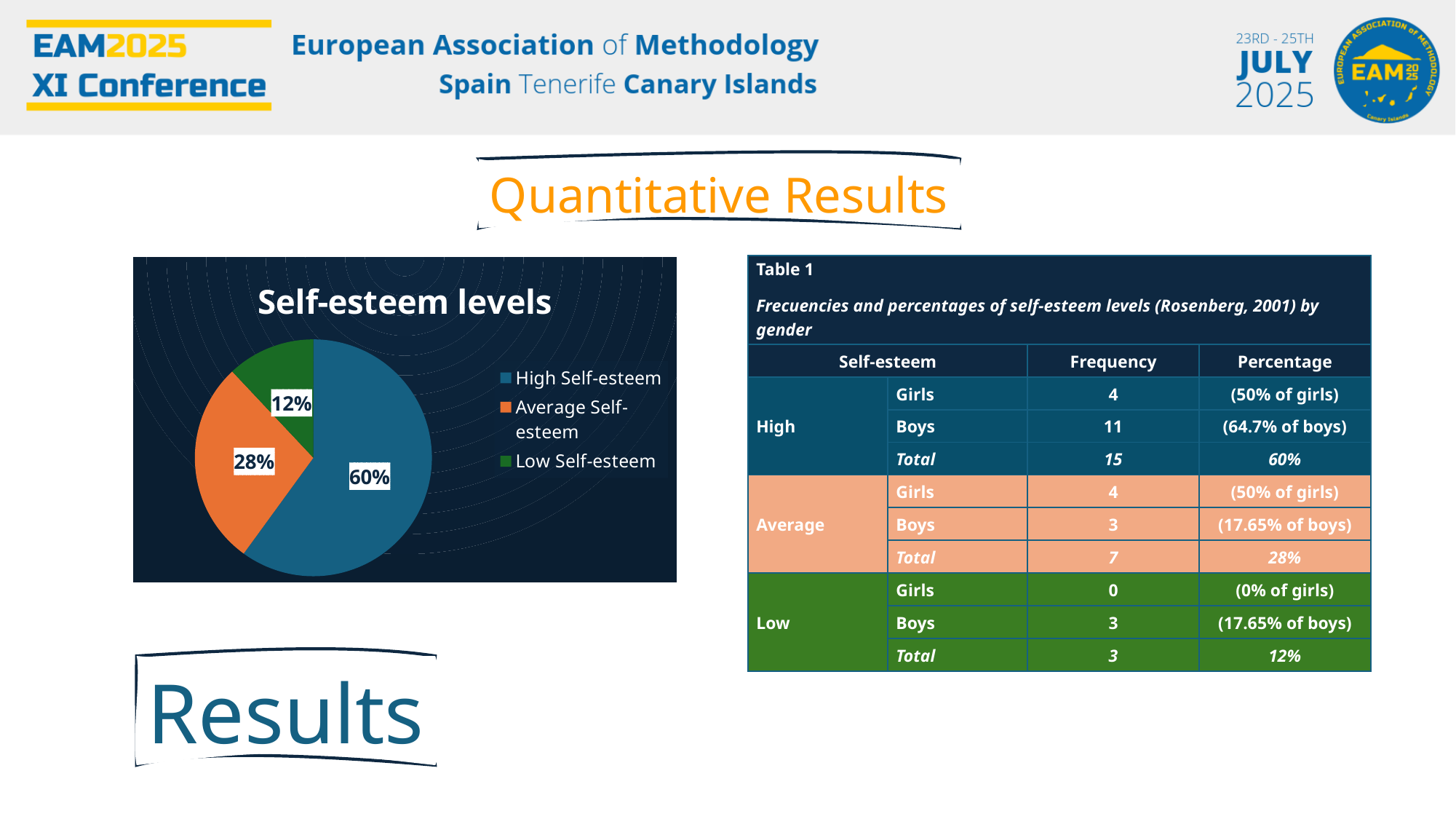
What share of the pie does Average Self-esteem represent? 28% Which slice is larger, Average Self-esteem or Low Self-esteem? Average Self-esteem Which category has the smallest slice of the pie? Low Self-esteem What is the title of the chart? Self-esteem levels Which category has the largest slice of the pie? High Self-esteem How many categories does the pie chart show? 3 What is the difference in percentage points between the High Self-esteem and Average Self-esteem slices? 32 What share of the pie does High Self-esteem represent? 60% What is the difference in percentage points between the Average Self-esteem and Low Self-esteem slices? 16 What colour is the Low Self-esteem slice? Green What type of chart is shown on the slide? Pie chart What share of the pie does Low Self-esteem represent? 12%